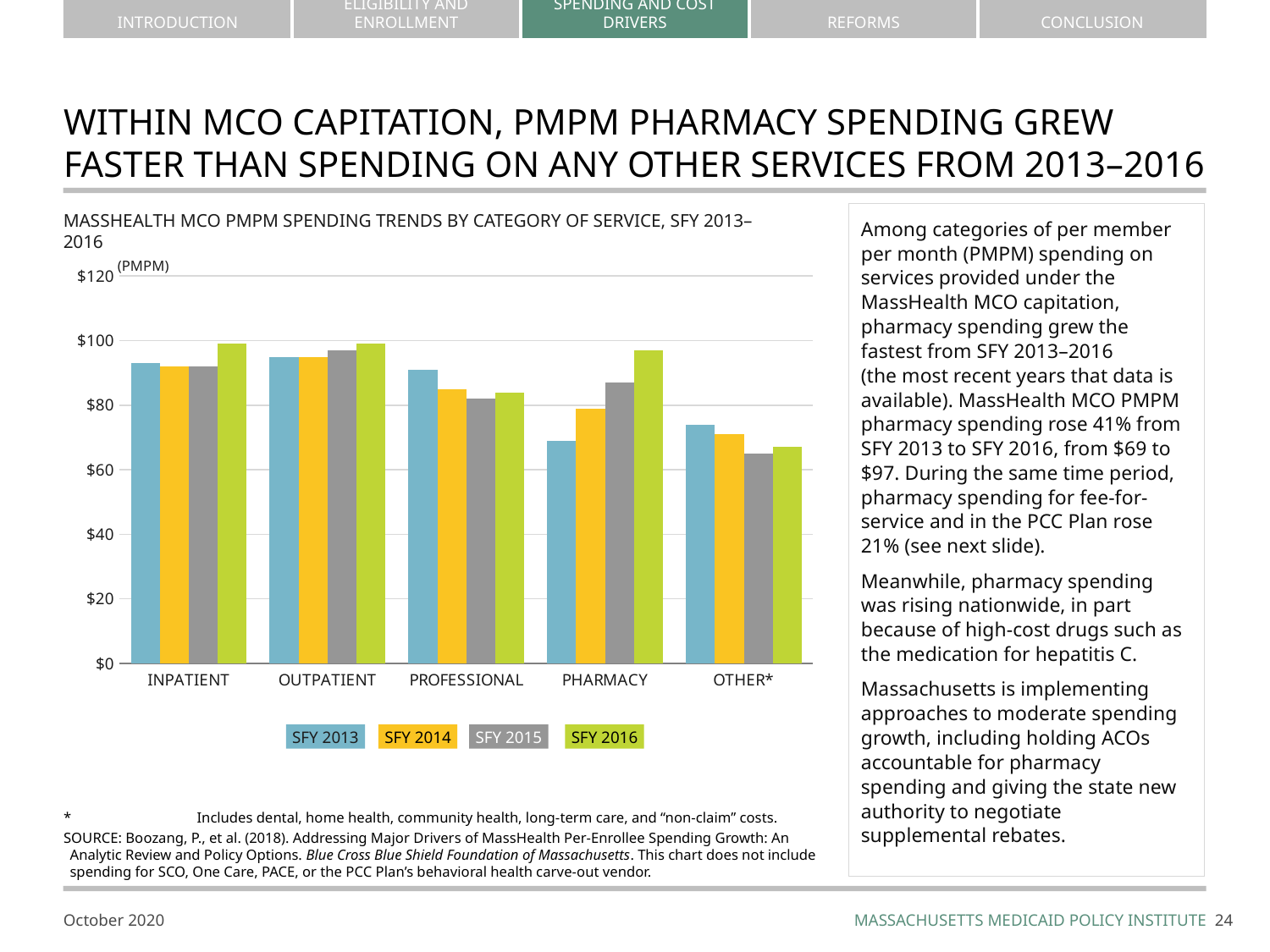
For SFY 2016, which is larger: PMPM spending for PHARMACY or for OTHER*? PHARMACY How many series does the chart legend list? 4 Is the SFY 2013 value for INPATIENT greater or less than $80? greater Which category of service has the lowest PMPM spending for SFY 2013? PHARMACY Is the SFY 2015 value for OTHER* greater or less than $80? less Is the SFY 2013 value for PHARMACY greater or less than $80? less How many categories of service are shown on the x axis of the chart? 5 Which fiscal year has the highest PMPM spending in the PHARMACY category? SFY 2016 Which fiscal year has the lowest PMPM spending in the OTHER* category? SFY 2015 What is the title of the chart? MASSHEALTH MCO PMPM SPENDING TRENDS BY CATEGORY OF SERVICE, SFY 2013–2016 What kind of chart is shown on the slide? bar chart Does PMPM spending for PHARMACY rise or fall from SFY 2013 to SFY 2016? rise